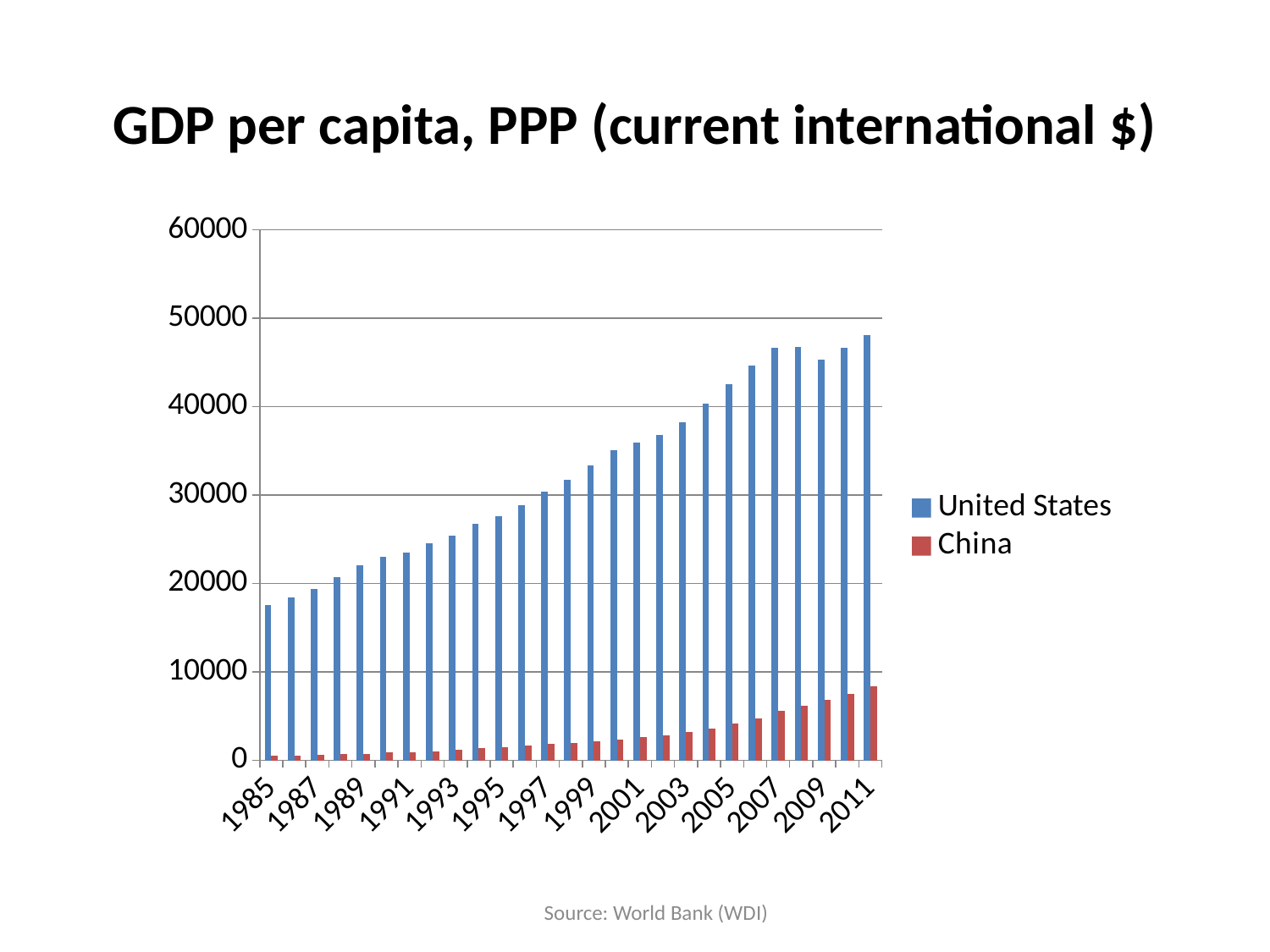
In which year is the United States value lowest? 1985 In which year is the China value highest? 2011 How many series does the legend list? 2 Is the value for the United States in 2011 greater or less than 40000? greater Which series is shown in blue? United States Which is larger in 2011, the value for the United States or the value for China? United States Is the value for the United States in 1985 greater or less than 20000? less What kind of chart is shown on the slide? Bar chart Do the China values generally rise or fall from 1985 to 2011? Rise What is the title of the chart? GDP per capita, PPP (current international $) In which year is the United States value highest? 2011 Is the value for China in 2011 greater or less than 10000? less